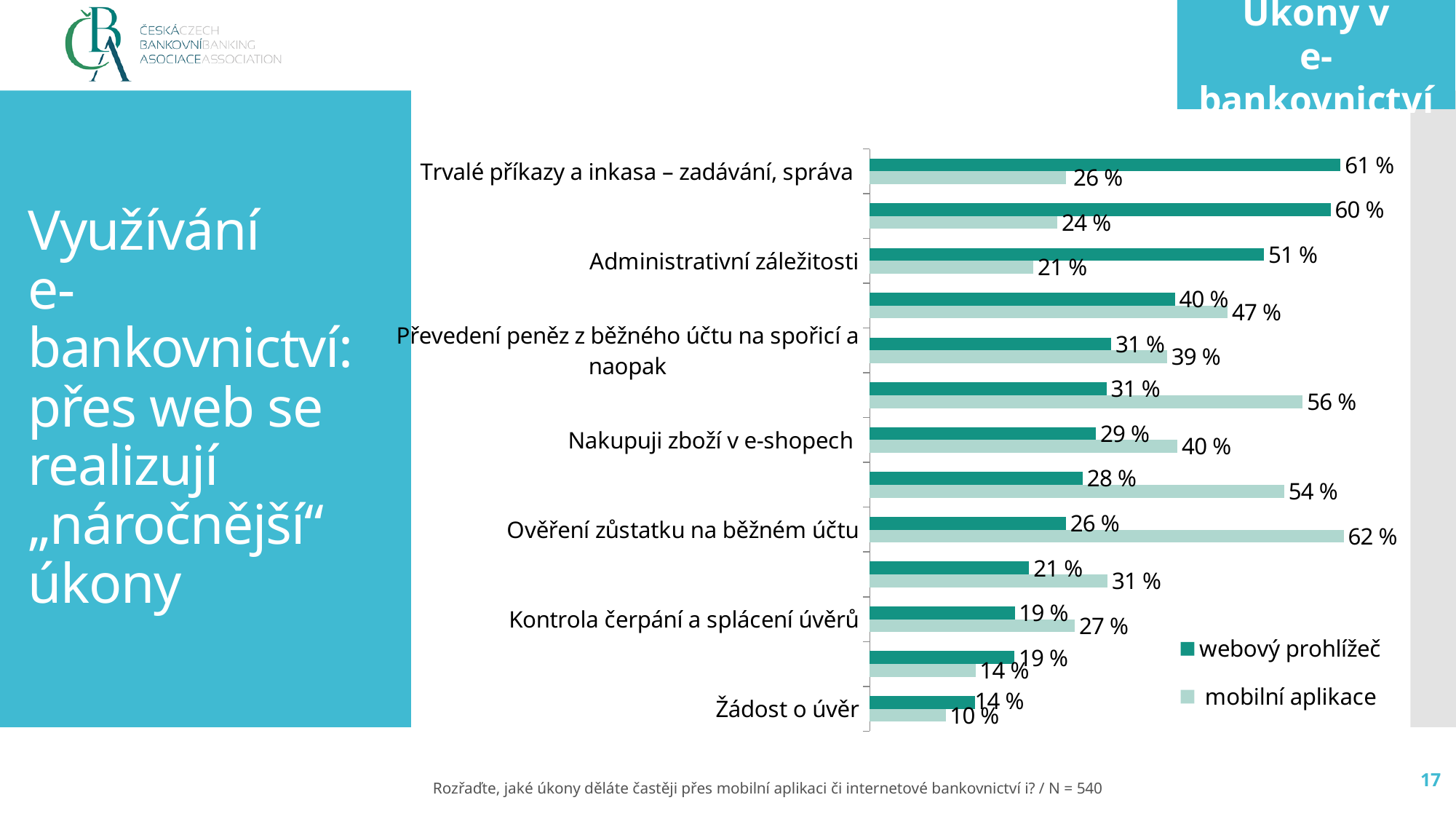
What is the value for 'webový prohlížeč' for 'Administrativní záležitosti'? 51 % What is the value for 'webový prohlížeč' for 'Trvalé příkazy a inkasa – zadávání, správa'? 61 % What kind of chart is shown on the slide? bar chart What is the difference between the 'webový prohlížeč' and 'mobilní aplikace' values for 'Trvalé příkazy a inkasa – zadávání, správa'? 35 percentage points What is the value for 'mobilní aplikace' for 'Ověření zůstatku na běžném účtu'? 62 % Which labelled category has the lowest value for 'webový prohlížeč'? Žádost o úvěr What is the value for 'mobilní aplikace' for 'Žádost o úvěr'? 10 % Which labelled category has the highest value for 'mobilní aplikace'? Ověření zůstatku na běžném účtu For 'Nakupuji zboží v e-shopech', which is larger: 'webový prohlížeč' or 'mobilní aplikace'? mobilní aplikace Which legend entry is shown in the darker teal colour? webový prohlížeč How many series does the legend list? 2 For 'Kontrola čerpání a splácení úvěrů', which is larger: 'webový prohlížeč' or 'mobilní aplikace'? mobilní aplikace